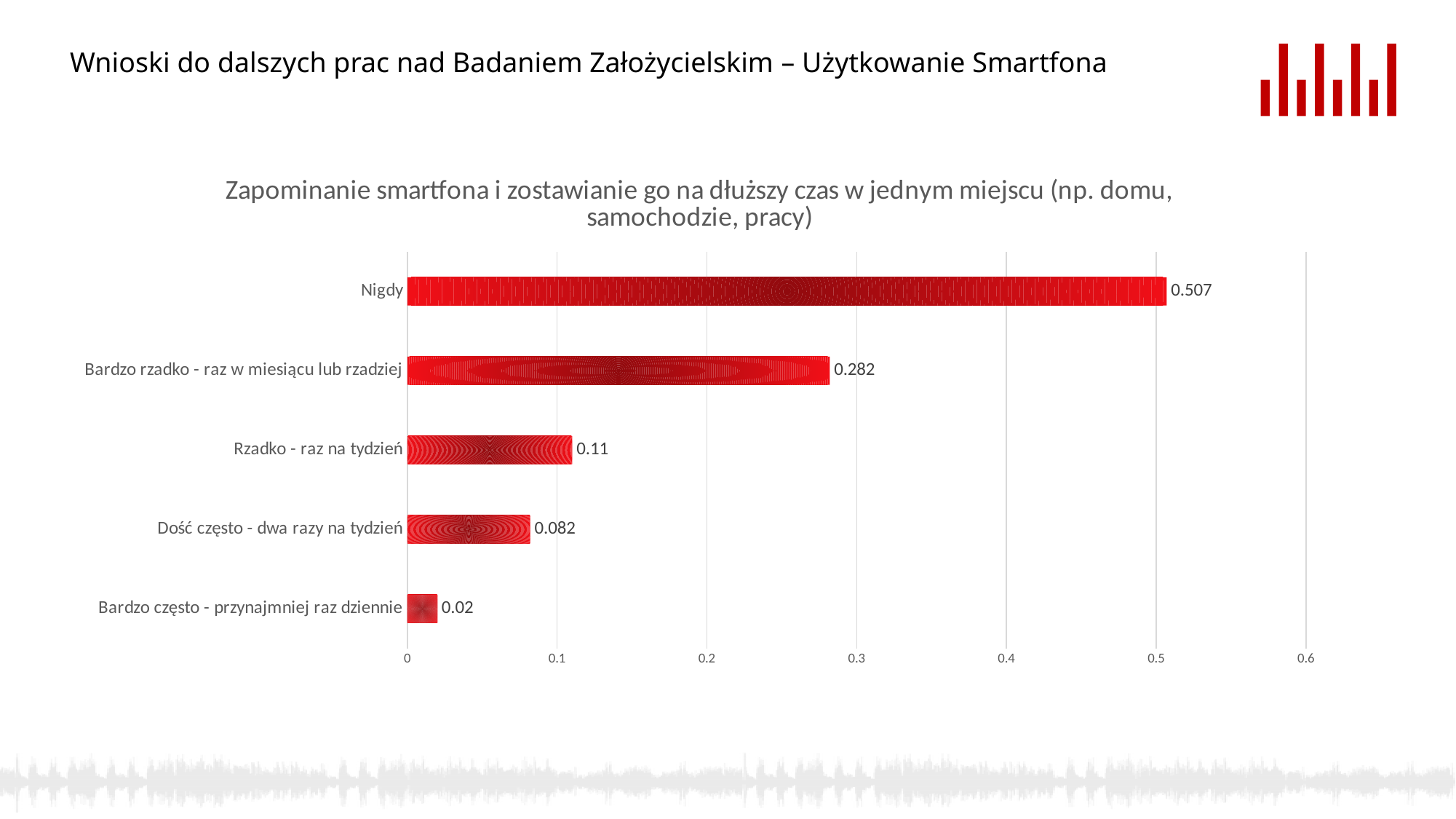
Which category has the highest value? Nigdy What is the value for "Bardzo często - przynajmniej raz dziennie"? 0.02 What is the value for "Bardzo rzadko - raz w miesiącu lub rzadziej"? 0.282 How many categories are shown in the chart? 5 Is the value for "Nigdy" greater or less than 0.5? greater Which category has the lowest value? Bardzo często - przynajmniej raz dziennie What kind of chart is shown on the slide? Bar chart What is the value for "Dość często - dwa razy na tydzień"? 0.082 What is the value for "Nigdy"? 0.507 What is the value for "Rzadko - raz na tydzień"? 0.11 What is the difference between the values for "Nigdy" and "Bardzo rzadko - raz w miesiącu lub rzadziej"? 0.225 Which is larger: the value for "Rzadko - raz na tydzień" or for "Dość często - dwa razy na tydzień"? Rzadko - raz na tydzień